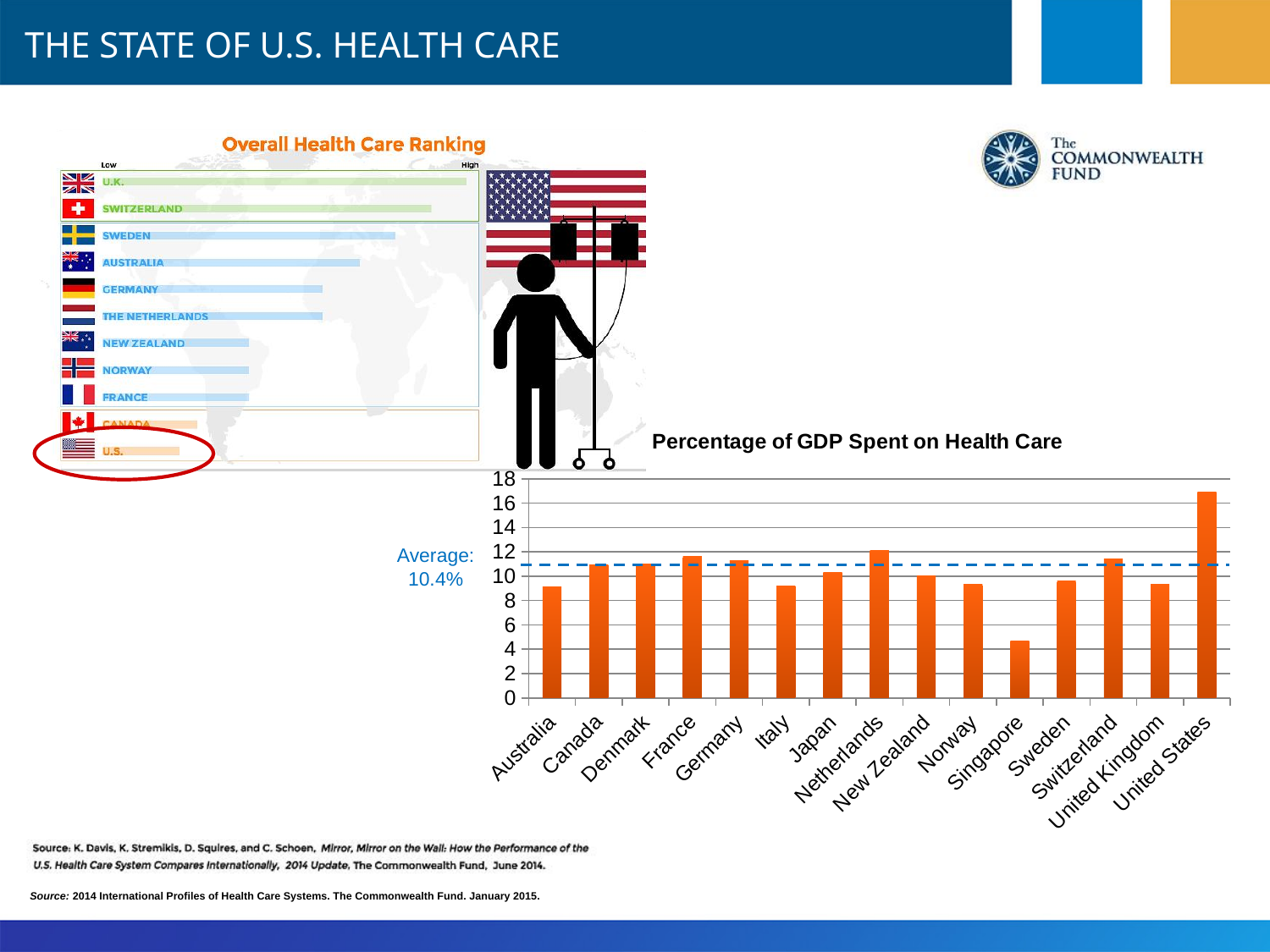
In the 'Percentage of GDP Spent on Health Care' chart, is the value for Singapore greater or less than 6? less In the 'Percentage of GDP Spent on Health Care' chart, which is larger, the value for the United States or the value for Canada? United States In the 'Percentage of GDP Spent on Health Care' chart, which is larger, the value for Singapore or the value for Sweden? Sweden In the 'Percentage of GDP Spent on Health Care' chart, which country has the lowest value? Singapore In the 'Overall Health Care Ranking' chart on the left, which country is ranked highest? U.K. In the 'Percentage of GDP Spent on Health Care' chart, is the value for France greater or less than 10? greater How many countries are shown in the 'Percentage of GDP Spent on Health Care' chart? 15 In the 'Percentage of GDP Spent on Health Care' chart, is the value for Australia greater or less than 10? less In the 'Percentage of GDP Spent on Health Care' chart, which country has the highest value? United States What kind of chart is 'Percentage of GDP Spent on Health Care'? bar chart What average value is marked by the dashed line in the 'Percentage of GDP Spent on Health Care' chart? 10.4%